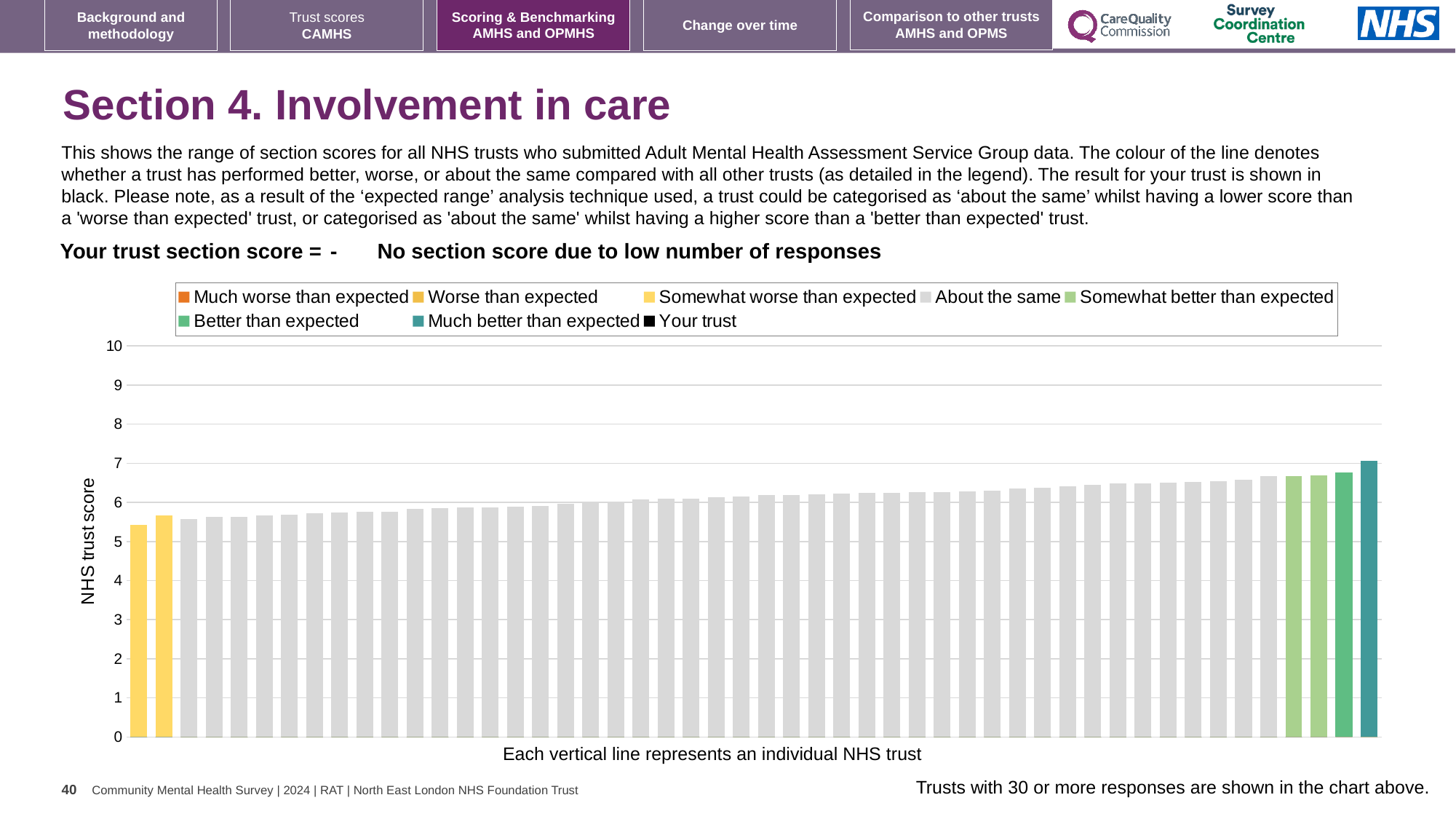
What is the label on the vertical axis of the chart? NHS trust score Do the bar values rise or fall from left to right across the chart? Rise What kind of chart is shown on the slide? Bar chart What does the caption below the horizontal axis say each vertical line represents? An individual NHS trust Is the value of the rightmost bar greater or less than 6? greater Which bar is taller, the leftmost bar or the rightmost bar? The rightmost bar Is the value of the tallest bar greater or less than 8? less How many entries does the chart legend list? 8 Is the value of the leftmost bar greater or less than 6? less